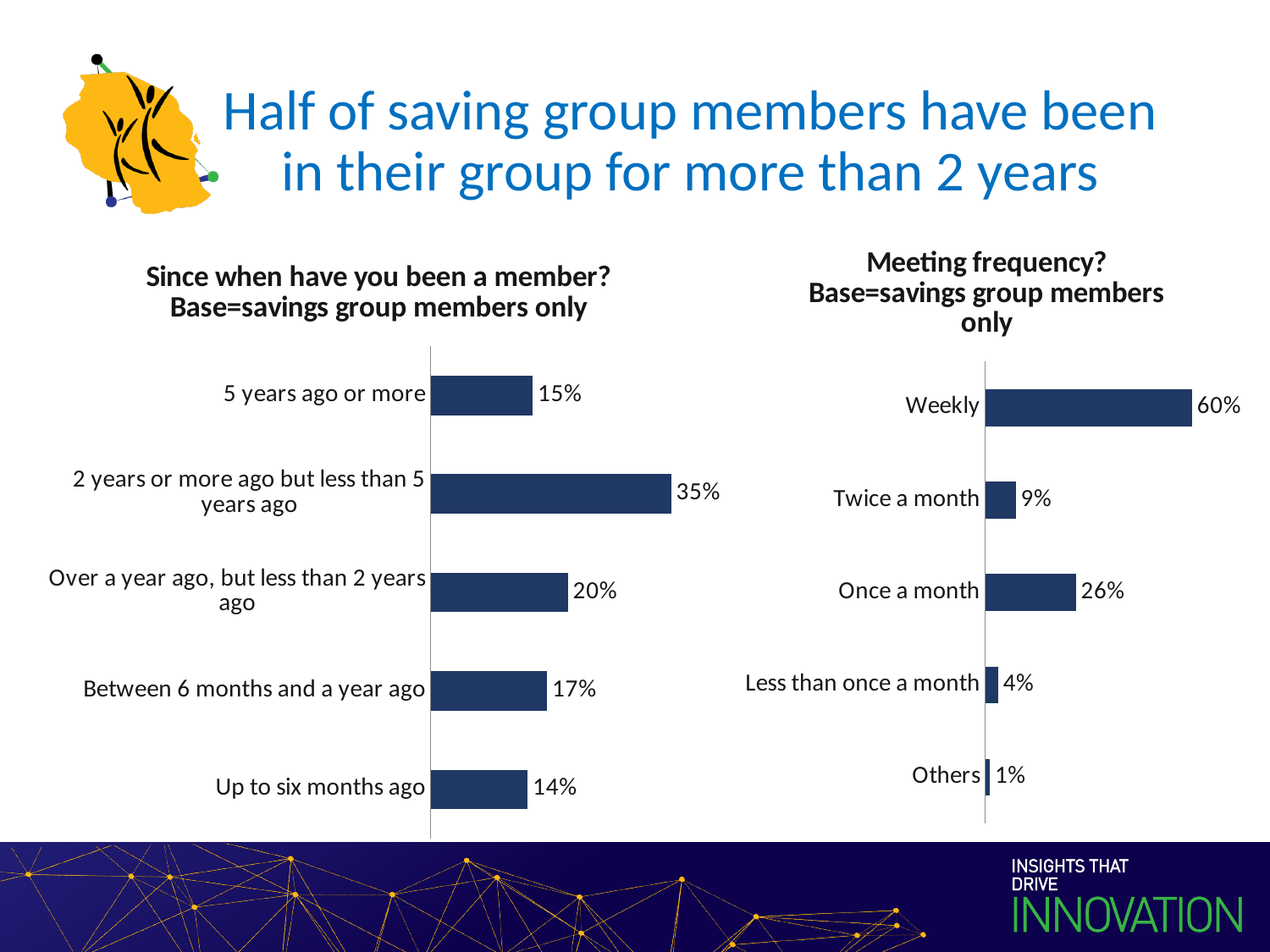
In the 'Meeting frequency?' chart, what is the value for 'Weekly'? 60% In the 'Since when have you been a member?' chart, what is the difference between '2 years or more ago but less than 5 years ago' and 'Over a year ago, but less than 2 years ago'? 15% In the 'Meeting frequency?' chart, which category has the lowest value? Others In the 'Since when have you been a member?' chart, how many categories are shown? 5 In the 'Meeting frequency?' chart, what is the value for 'Less than once a month'? 4% In the 'Since when have you been a member?' chart, which category has the highest value? 2 years or more ago but less than 5 years ago In the 'Since when have you been a member?' chart, what is the value for '2 years or more ago but less than 5 years ago'? 35% In the 'Since when have you been a member?' chart, which category has the lowest value? Up to six months ago What type of chart is the 'Meeting frequency?' chart? Bar chart In the 'Since when have you been a member?' chart, what is the value for 'Up to six months ago'? 14% In the 'Meeting frequency?' chart, which is larger: 'Twice a month' or 'Once a month'? Once a month In the 'Meeting frequency?' chart, what is the difference between 'Weekly' and 'Once a month'? 34%